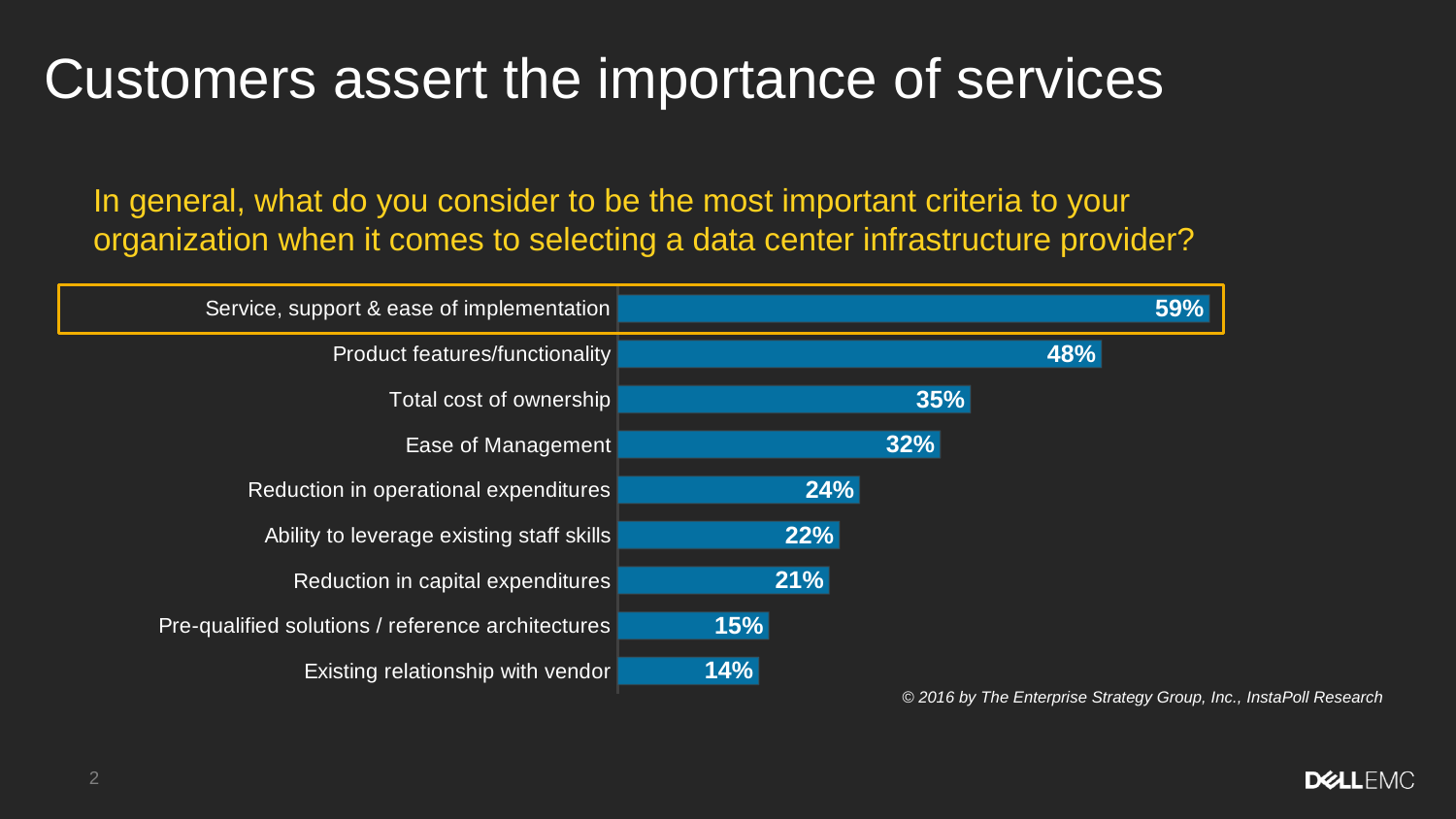
Which criterion has the lowest percentage in the chart? Existing relationship with vendor Which bar on the chart is highlighted with an orange outline? Service, support & ease of implementation What is the difference in percentage points between 'Service, support & ease of implementation' and 'Product features/functionality'? 11 percentage points What type of chart is shown on the slide? Bar chart What is the difference between 'Ease of Management' and 'Reduction in operational expenditures'? 8 percentage points How many criteria are shown in the chart? 9 What percentage is shown for 'Reduction in capital expenditures'? 21% Which has a higher value: 'Ability to leverage existing staff skills' or 'Pre-qualified solutions / reference architectures'? Ability to leverage existing staff skills Which criterion has the highest percentage in the chart? Service, support & ease of implementation What percentage of respondents selected 'Service, support & ease of implementation' as a most important criterion? 59% What is the value shown for 'Total cost of ownership'? 35% Do the values increase or decrease from the top bar to the bottom bar? Decrease